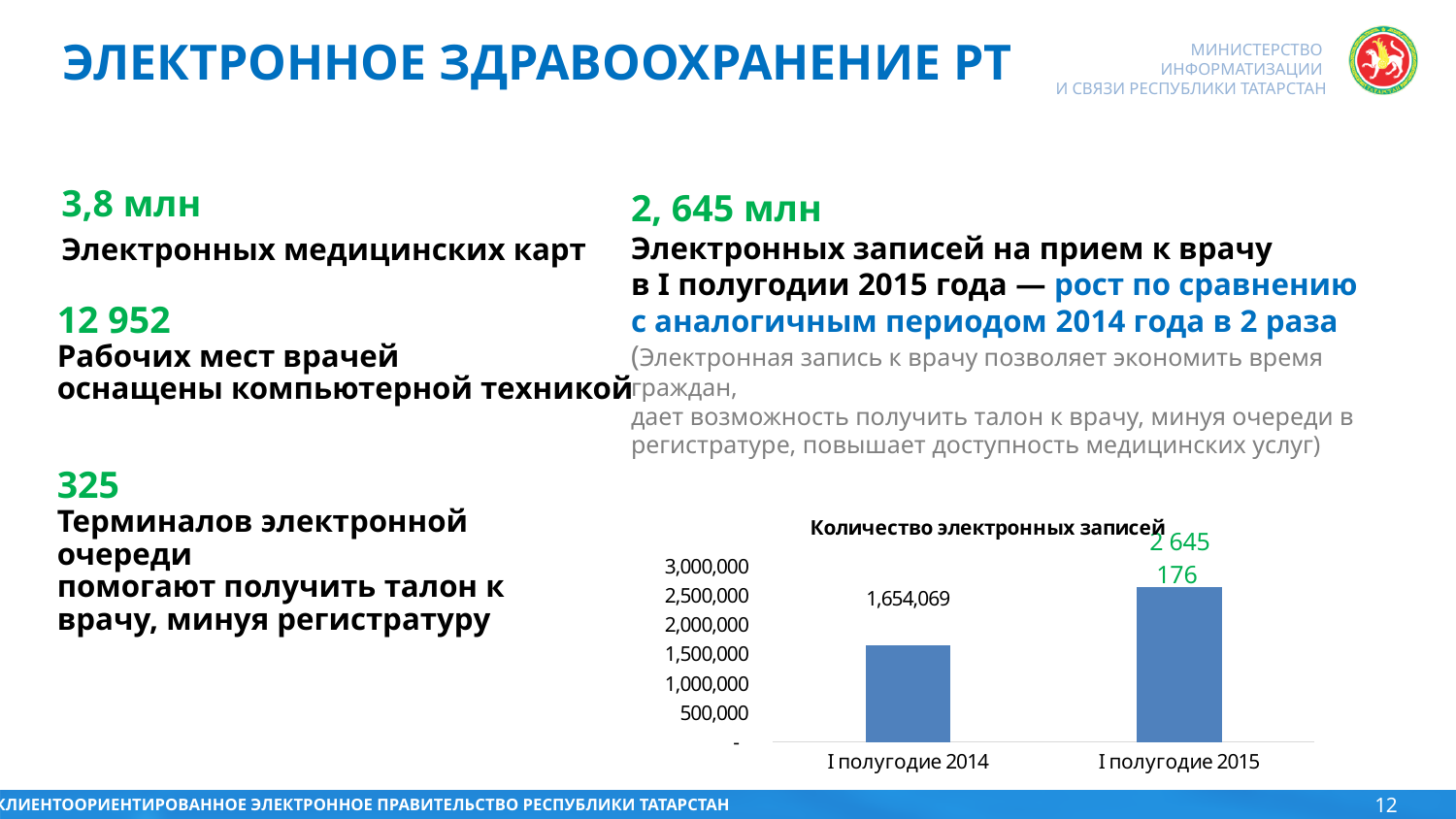
How many categories are shown on the x axis of the chart? 2 What is the value for I полугодие 2015 in the chart? 2 645 176 Do the values rise or fall from I полугодие 2014 to I полугодие 2015? rise What type of chart is shown on the slide? bar chart Is the value for I полугодие 2014 greater or less than 2,000,000? less Is the value for I полугодие 2015 greater or less than 2,500,000? greater Which category has the lowest value in the chart? I полугодие 2014 Which is larger, the value for I полугодие 2014 or I полугодие 2015? I полугодие 2015 Which category has the highest value in the chart? I полугодие 2015 What is the title of the chart on the slide? Количество электронных записей What is the difference between the values for I полугодие 2015 and I полугодие 2014? 991,107 What is the value for I полугодие 2014 in the chart? 1,654,069